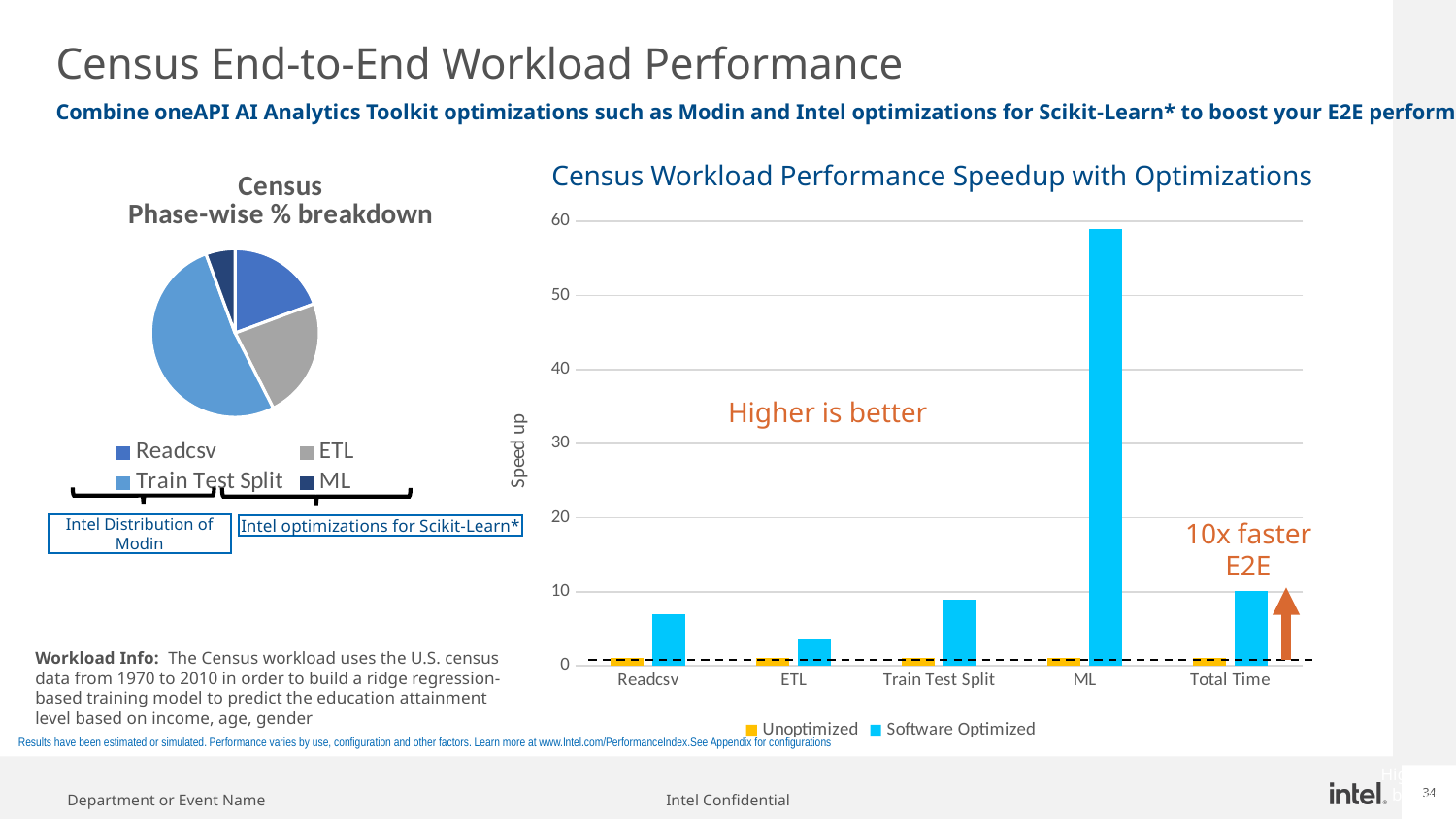
What is the y-axis label of the 'Census Workload Performance Speedup with Optimizations' chart? Speed up In the 'Census Phase-wise % breakdown' pie chart, how many slices are there? 4 In the 'Census Phase-wise % breakdown' pie chart, which phase has the largest slice? Train Test Split What kind of chart is the 'Census Workload Performance Speedup with Optimizations' chart? bar chart What kind of chart is the 'Census Phase-wise % breakdown' chart? pie chart In the 'Census Workload Performance Speedup with Optimizations' chart, how many categories are shown on the x axis? 5 In the 'Census Workload Performance Speedup with Optimizations' chart, is the Software Optimized value for Readcsv greater or less than 10? less In the 'Census Workload Performance Speedup with Optimizations' chart, which is larger: the Software Optimized value for ML or for Readcsv? ML In the 'Census Workload Performance Speedup with Optimizations' chart, is the Software Optimized value for ML greater or less than 50? greater In the 'Census Workload Performance Speedup with Optimizations' chart, how many series does the legend list? 2 In the 'Census Workload Performance Speedup with Optimizations' chart, which category has the highest Software Optimized speedup? ML In the 'Census Workload Performance Speedup with Optimizations' chart, which category has the lowest Software Optimized speedup? ETL